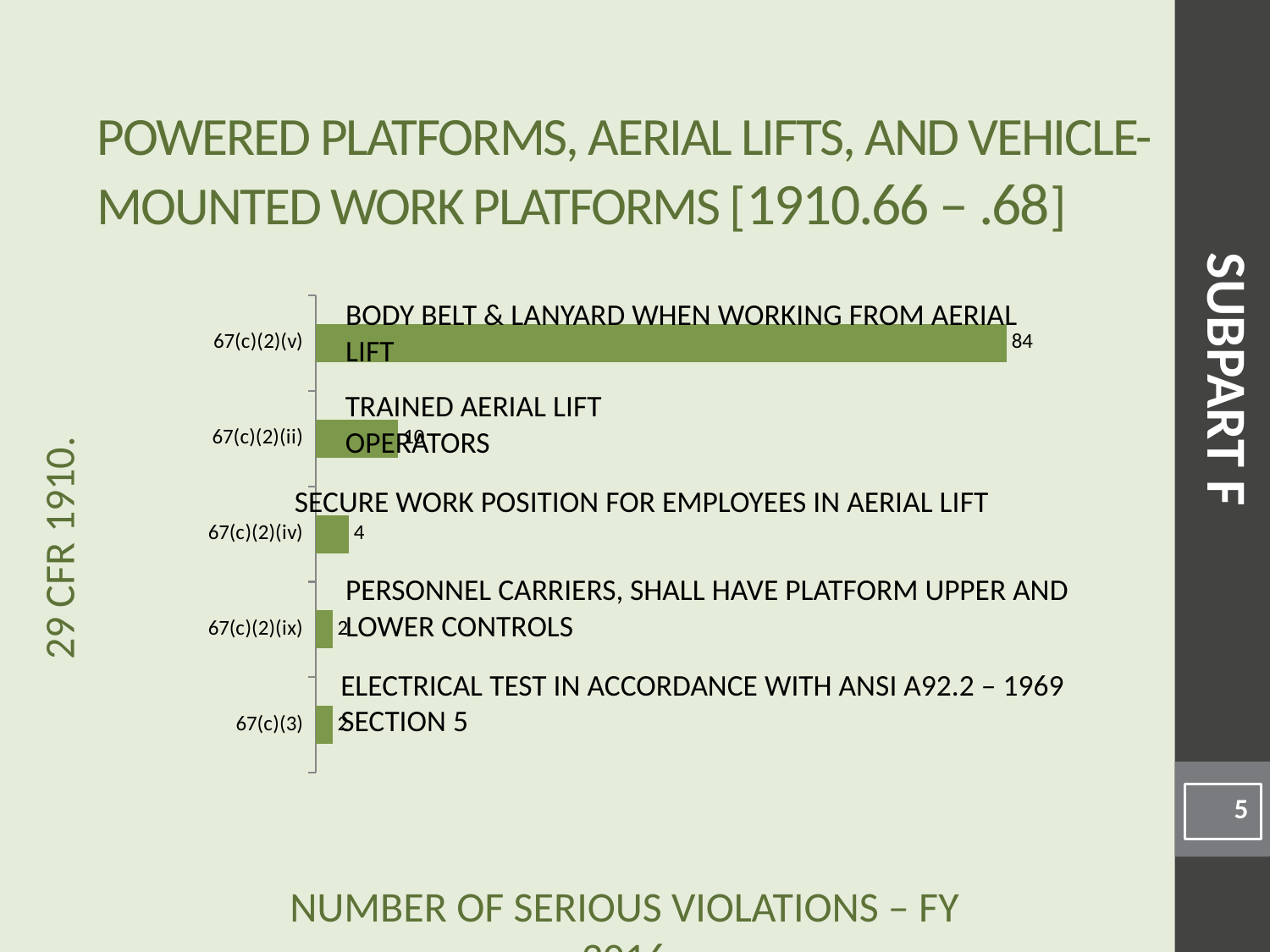
How many standards (categories) are shown in the chart? 5 Which standard is described as 'BODY BELT & LANYARD WHEN WORKING FROM AERIAL LIFT'? 67(c)(2)(v) What is the number of serious violations for 67(c)(2)(v)? 84 Which has more serious violations, 67(c)(2)(v) or 67(c)(2)(ii)? 67(c)(2)(v) What is the difference in serious violations between 67(c)(2)(v) and 67(c)(2)(ii)? 74 What is the number of serious violations for 67(c)(2)(ii)? 10 What is the difference in serious violations between 67(c)(2)(v) and 67(c)(2)(iv)? 80 Which has more serious violations, 67(c)(2)(ii) or 67(c)(2)(iv)? 67(c)(2)(ii) What is the difference in serious violations between 67(c)(2)(ii) and 67(c)(2)(iv)? 6 What type of chart is shown on the slide? Bar chart Which standard has the highest number of serious violations? 67(c)(2)(v) What is the number of serious violations for 67(c)(2)(iv)? 4